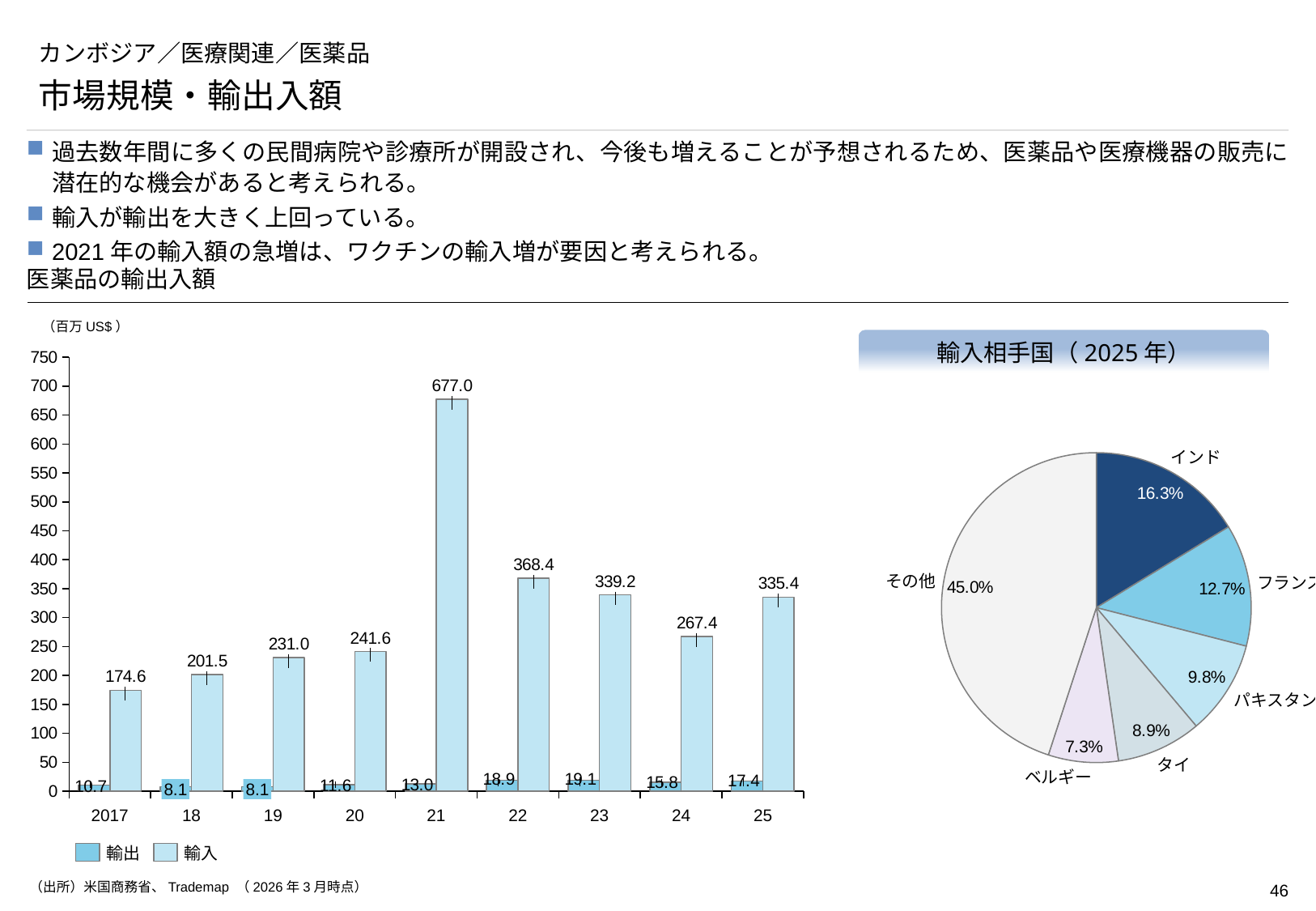
What kind of chart is 輸入相手国（2025年）? Pie chart In the bar chart 医薬品の輸出入額, do the 輸入 values rise or fall from 2017 to 2020? Rise In the bar chart 医薬品の輸出入額, which year has the highest 輸入 value? 2021 In the bar chart 医薬品の輸出入額, how many years are shown on the x axis? 9 In the bar chart 医薬品の輸出入額, what is the difference between the 輸入 values for 2022 and 2023? 29.2 In the bar chart 医薬品の輸出入額, what is the 輸入 value for 2021? 677.0 In the bar chart 医薬品の輸出入額, which year has the lowest 輸入 value? 2017 In the pie chart 輸入相手国（2025年）, which named country has the smallest share? ベルギー In the pie chart 輸入相手国（2025年）, what share does インド have? 16.3% In the bar chart 医薬品の輸出入額, is the 輸入 value for 2024 larger than the 輸入 value for 2025? No, 2025 is larger (335.4 vs 267.4) In the bar chart 医薬品の輸出入額, how many series does the legend list? 2 In the bar chart 医薬品の輸出入額, what is the 輸出 value for 2023? 19.1